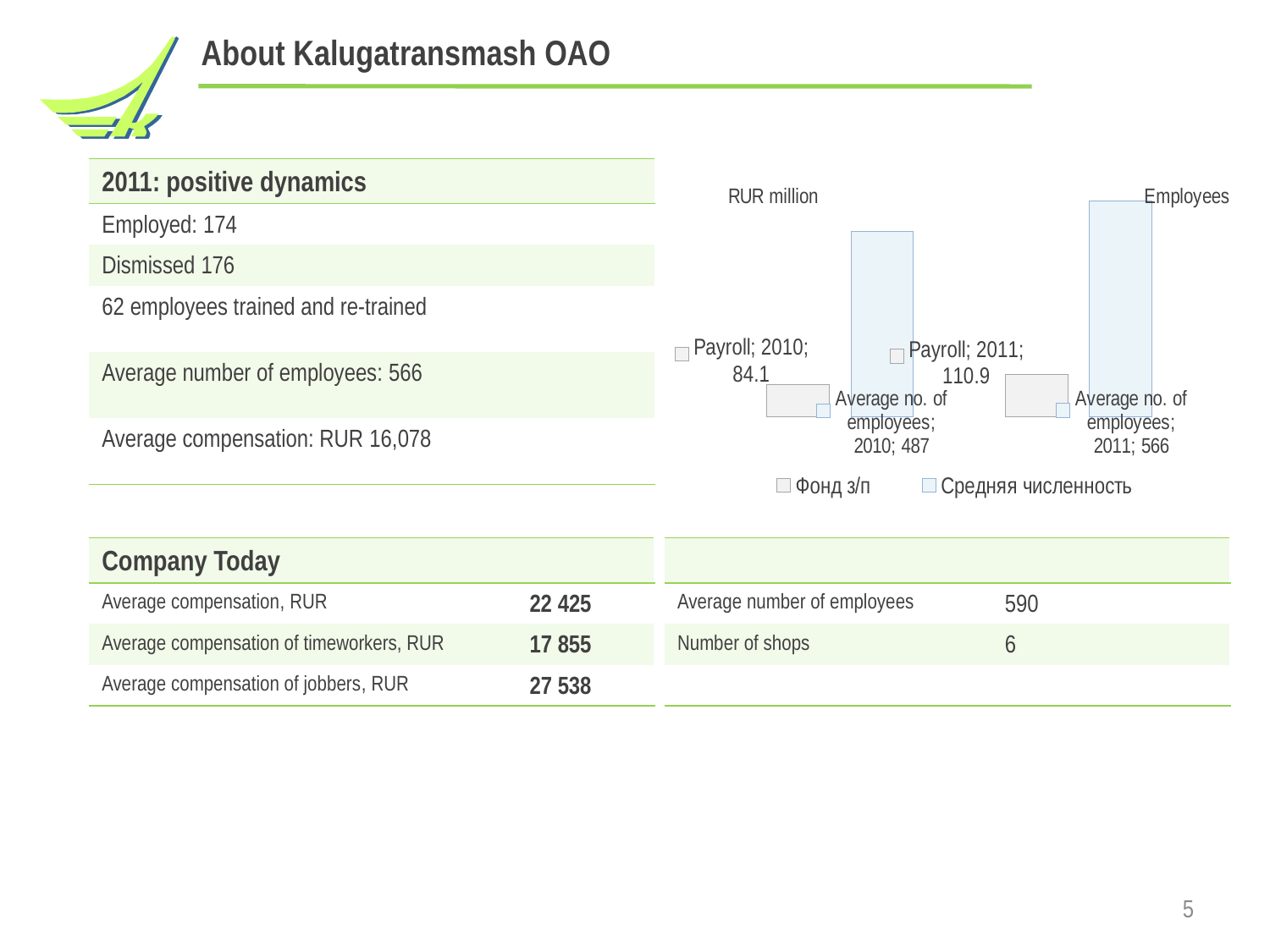
What is the average number of employees for 2010 shown in the chart? 487 By how much did the payroll increase from 2010 to 2011 according to the chart? 26.8 Which year has the lower average number of employees in the chart? 2010 What type of chart is shown on the slide? Bar chart What is the payroll value for 2011 in the chart? 110.9 What unit is shown on the left axis label of the chart? RUR million What is the payroll value for 2010 in the chart? 84.1 How many series does the chart legend list? 2 What is the average number of employees for 2011 shown in the chart? 566 Do the payroll values rise or fall from 2010 to 2011 in the chart? Rise By how much did the average number of employees increase from 2010 to 2011 according to the chart? 79 Which year has the higher payroll in the chart, 2010 or 2011? 2011